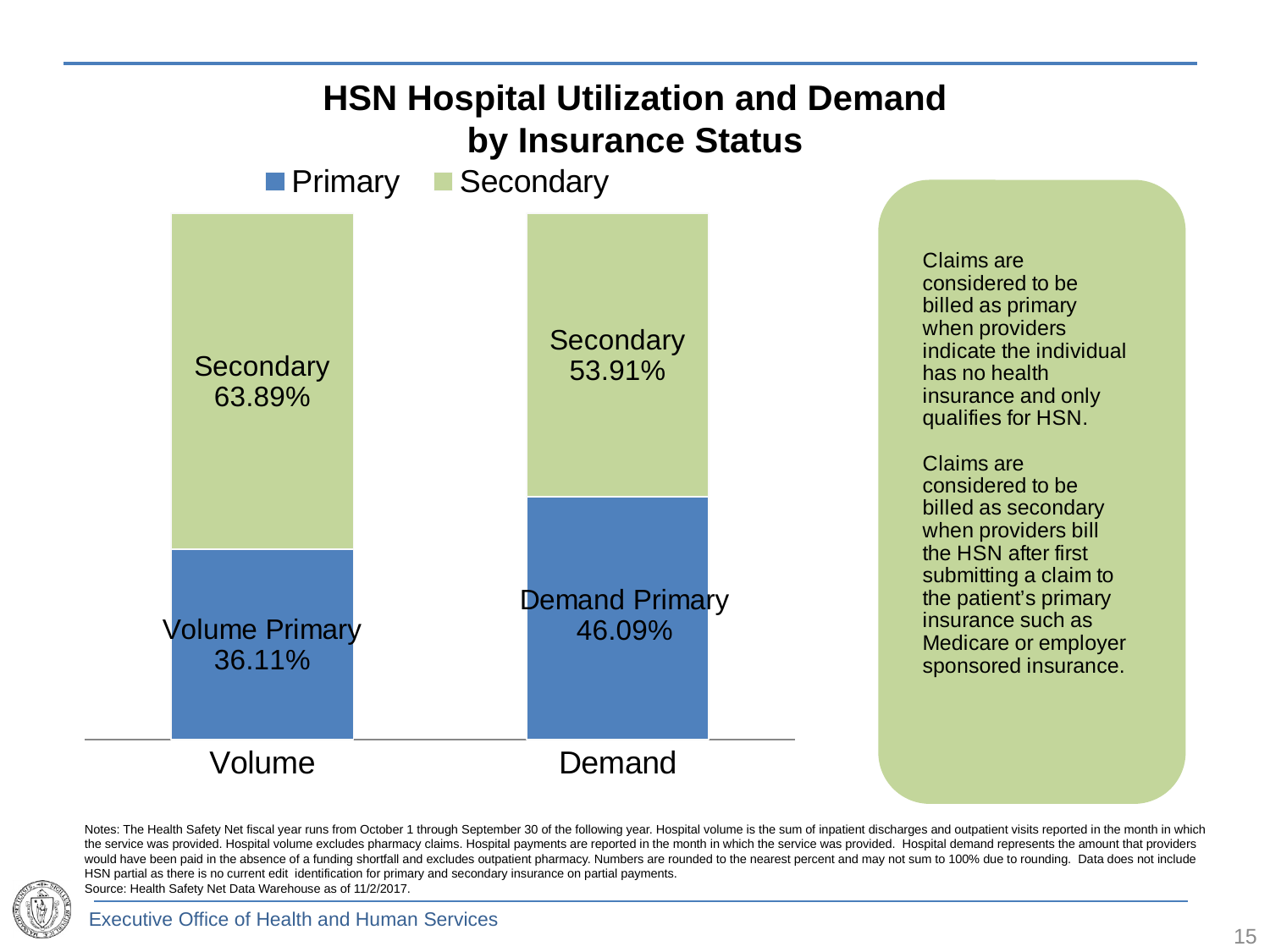
Which category has the higher Secondary share, Volume or Demand? Volume What kind of chart is shown? Stacked bar chart How many series does the legend list? 2 What is the Secondary share for Volume? 63.89% What is the title of the chart? HSN Hospital Utilization and Demand by Insurance Status Which category has the higher Primary share, Volume or Demand? Demand What is the Primary share for Volume? 36.11% What is the Secondary share for Demand? 53.91% What is the difference between the Secondary share for Volume and the Secondary share for Demand? 9.98% How many categories are shown on the x axis? 2 What is the difference between the Primary share for Demand and the Primary share for Volume? 9.98% What is the Primary share for Demand? 46.09%